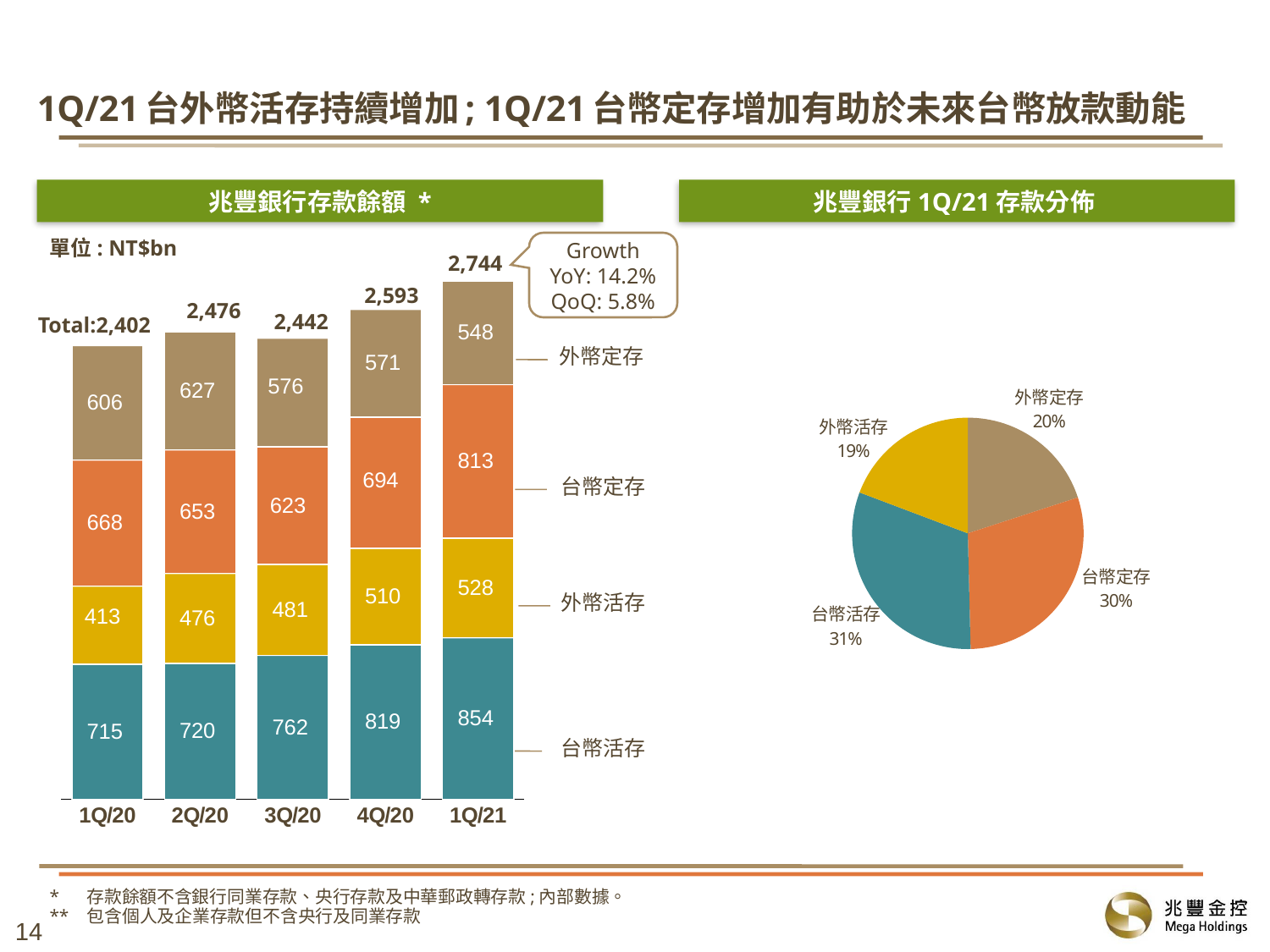
In the 兆豐銀行存款餘額 chart, which quarter has the highest total deposits? 1Q/21 In the 兆豐銀行存款餘額 chart, is 外幣活存 larger in 3Q/20 or in 4Q/20? 4Q/20 In the 兆豐銀行存款餘額 chart, which quarter has the lowest total deposits? 1Q/20 In the 兆豐銀行 1Q/21 存款分佈 pie chart, what share does 台幣活存 have? 31% In the 兆豐銀行存款餘額 chart, what is the value of 台幣活存 for 1Q/21? 854 In the 兆豐銀行 1Q/21 存款分佈 pie chart, which category has the smallest share? 外幣活存 In the 兆豐銀行存款餘額 chart, what is the total for 4Q/20? 2,593 What type of chart is the 兆豐銀行存款餘額 chart? Stacked bar chart In the 兆豐銀行存款餘額 chart, does 台幣活存 rise or fall from 1Q/20 to 1Q/21? Rise In the 兆豐銀行存款餘額 chart, what is the value of 外幣定存 for 2Q/20? 627 How many quarters are shown in the 兆豐銀行存款餘額 chart? 5 In the 兆豐銀行存款餘額 chart, what is the difference in 台幣定存 between 1Q/21 and 4Q/20? 119